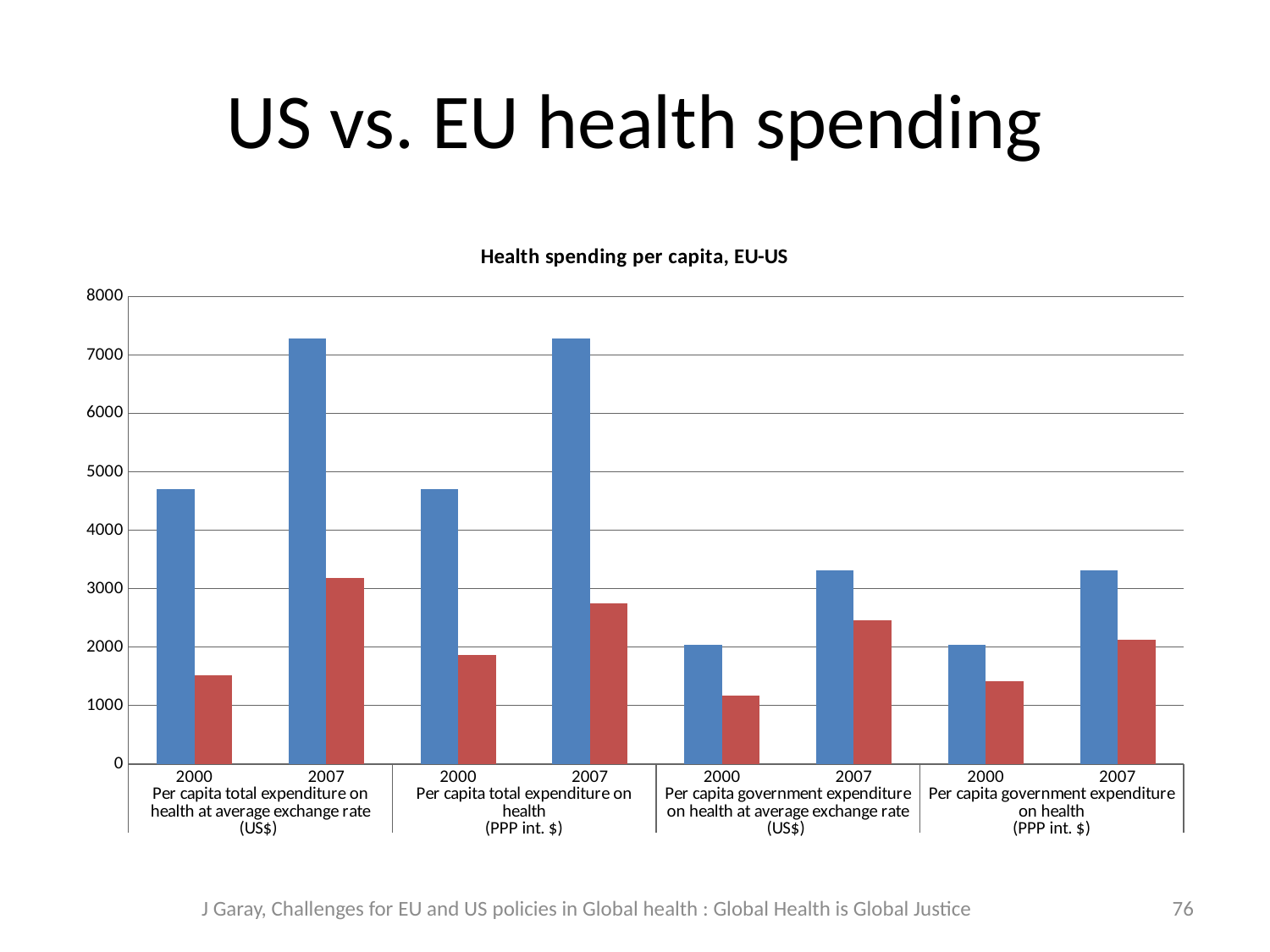
What kind of chart is shown on the slide? bar chart Within each expenditure measure, do the bars rise or fall from 2000 to 2007? rise Is the blue bar for 2000 under 'Per capita government expenditure on health (PPP int. $)' greater or less than 3000? less What is the title of the chart? Health spending per capita, EU-US How many expenditure measures (category groups) are shown along the x axis? 4 Is the red bar for 2000 under 'Per capita total expenditure on health at average exchange rate (US$)' greater or less than 2000? less Under 'Per capita government expenditure on health at average exchange rate (US$)', which year has the taller blue bar? 2007 How many bar colours (series) are plotted in the chart? 2 How many year labels appear along the x axis in total? 8 Under 'Per capita government expenditure on health (PPP int. $)' in 2007, which bar is taller, the blue or the red? blue Is the blue bar for 2007 under 'Per capita total expenditure on health at average exchange rate (US$)' greater or less than 7000? greater